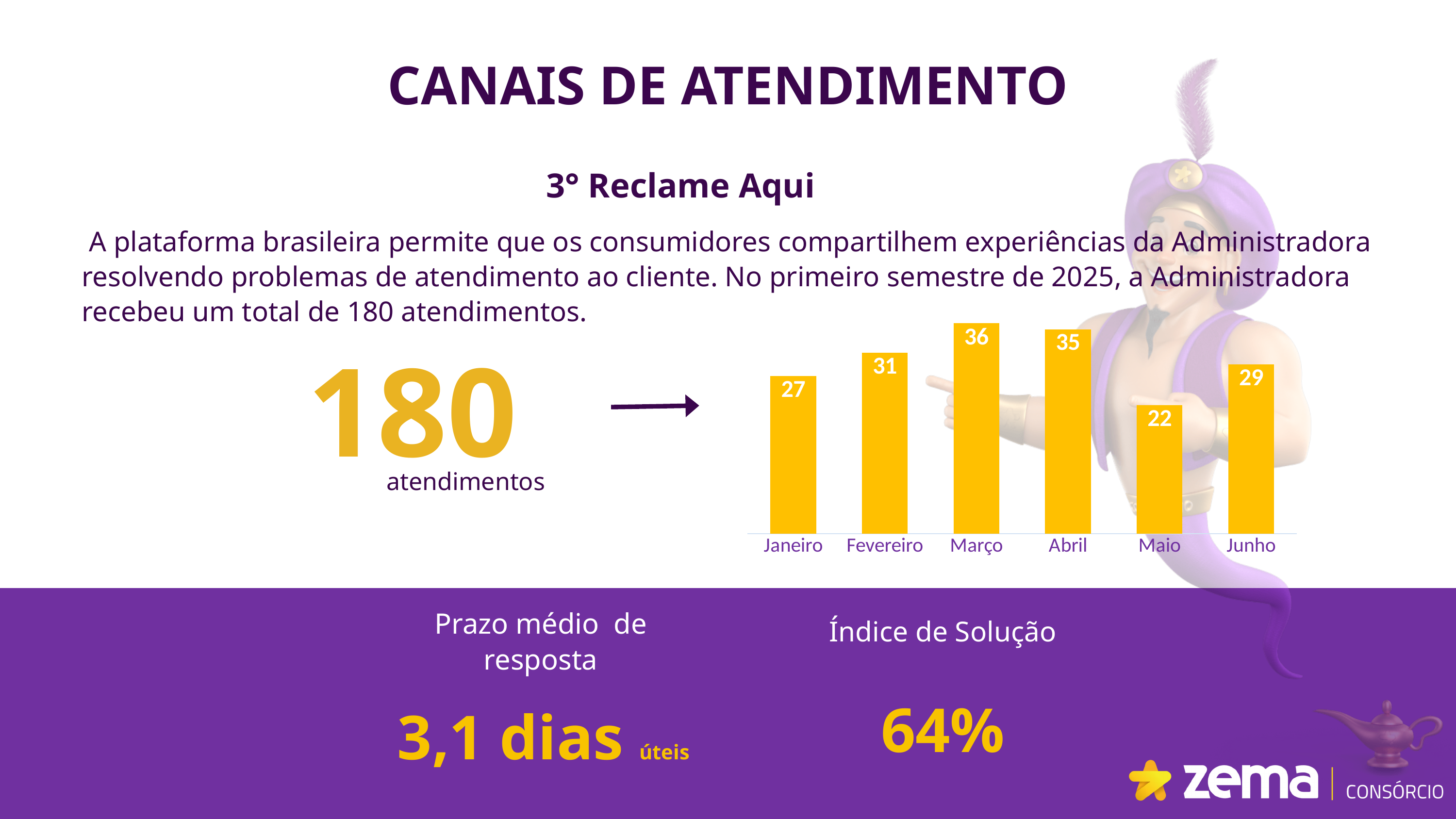
Which month has the lowest value? Maio What is the value for Maio? 22 What is the value for Janeiro? 27 Which month has the highest value? Março What is the difference between the values for Março and Maio? 14 What is the value for Março? 36 What colour are the bars in the chart? Yellow Which is larger, the value for Abril or the value for Junho? Abril What is the value for Junho? 29 What is the difference between the values for Fevereiro and Janeiro? 4 What kind of chart is shown on the slide? Bar chart How many months are shown in the chart? 6